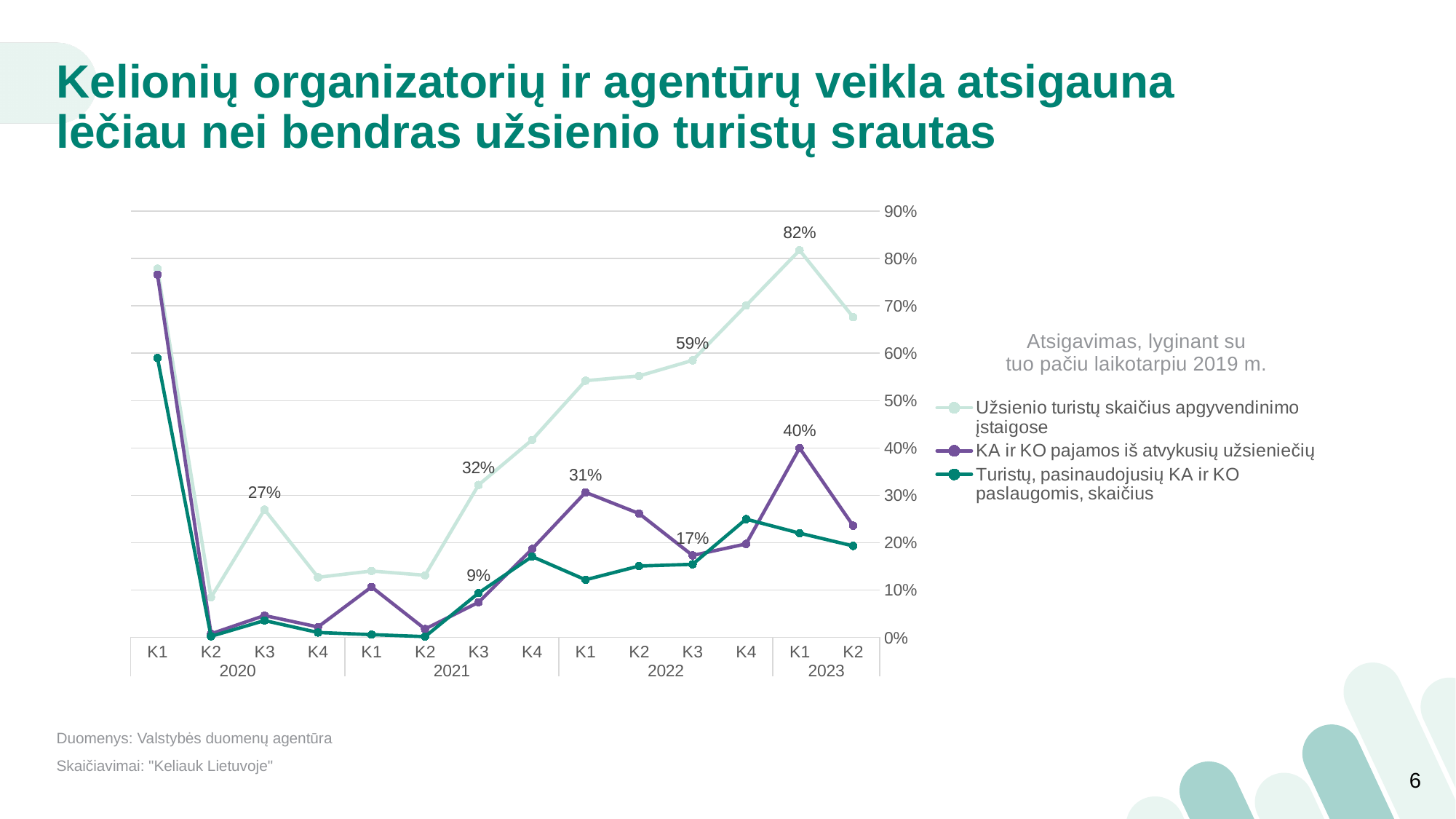
How many quarters are plotted along the x axis? 14 What kind of chart is shown on the slide? line chart Is the value for 'Turistų, pasinaudojusių KA ir KO paslaugomis, skaičius' in K4 2022 greater or less than 20%? greater What is the difference between the 'Užsienio turistų skaičius apgyvendinimo įstaigose' values in K1 2023 and K3 2022? 23 percentage points How many series does the legend list? 3 What is the value for 'Užsienio turistų skaičius apgyvendinimo įstaigose' in K3 2022? 59% What is the value for 'KA ir KO pajamos iš atvykusių užsieniečių' in K1 2023? 40% What is the source of the data given below the chart? Valstybės duomenų agentūra In K1 2023, which is larger: 'KA ir KO pajamos iš atvykusių užsieniečių' or 'Turistų, pasinaudojusių KA ir KO paslaugomis, skaičius'? KA ir KO pajamos iš atvykusių užsieniečių What is the value for 'Užsienio turistų skaičius apgyvendinimo įstaigose' in K1 2023? 82% In which quarter does 'Užsienio turistų skaičius apgyvendinimo įstaigose' reach its highest value? K1 2023 What is the value for 'KA ir KO pajamos iš atvykusių užsieniečių' in K1 2022? 31%